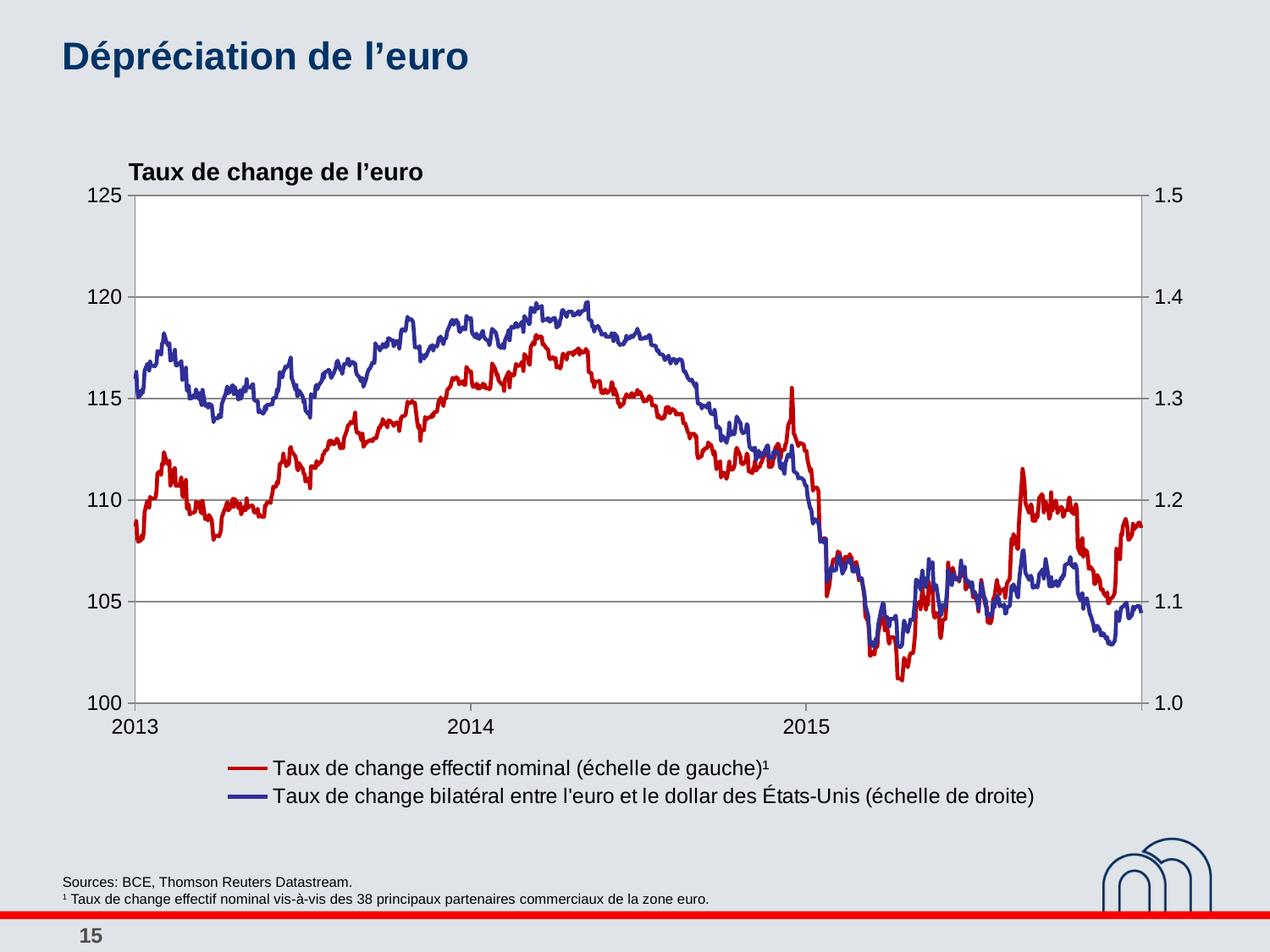
Does the 'Taux de change bilatéral entre l'euro et le dollar des États-Unis' series rise or fall between the start of 2014 and the end of 2015? fall Is the highest value reached by the 'Taux de change bilatéral entre l'euro et le dollar des États-Unis' series in 2014 greater or less than 1.3? greater How many years are labelled on the x axis? 3 Does the 'Taux de change effectif nominal' series rise or fall between the start of 2014 and the end of 2015? fall Is the lowest value reached by the 'Taux de change bilatéral entre l'euro et le dollar des États-Unis' series in 2015 greater or less than 1.1? less What is the title of the chart? Taux de change de l'euro Which axis does the series 'Taux de change effectif nominal' use, according to the legend? échelle de gauche (left axis) Is the lowest value reached by the 'Taux de change effectif nominal' series in 2015 greater or less than 105? less How many series does the legend list? 2 What kind of chart is shown on the slide? line chart Does the 'Taux de change effectif nominal' series rise or fall between the start of 2013 and the start of 2014? rise